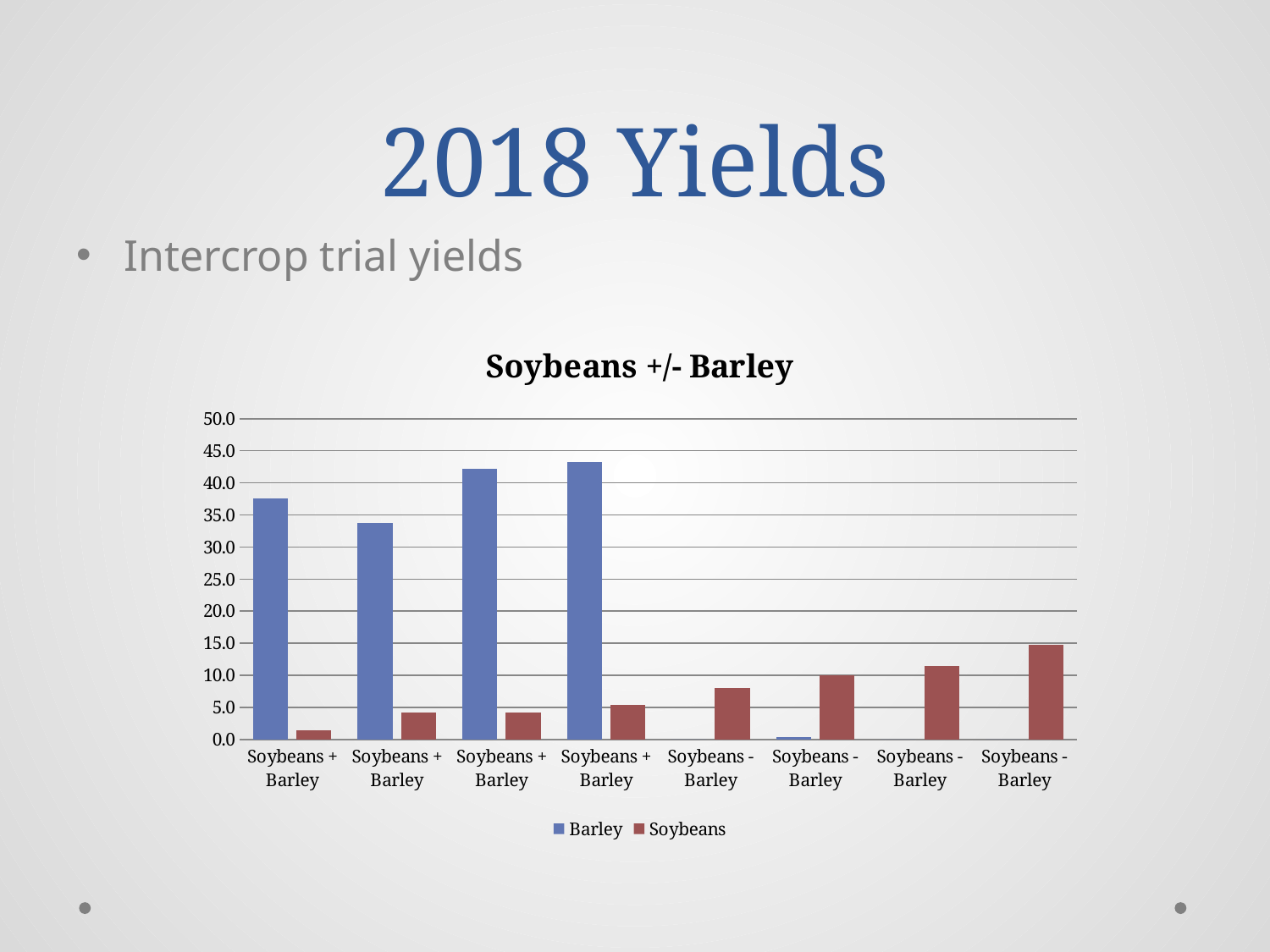
Is the Soybeans value for the last "Soybeans - Barley" category greater or less than 10.0? greater How many series does the legend list? 2 What are the two legend entries of the chart? Barley and Soybeans What kind of chart is shown on the slide? bar chart Is the Barley value for the first "Soybeans + Barley" category greater or less than 30.0? greater What is the title of the chart? Soybeans +/- Barley Which category has the highest Soybeans value? the last "Soybeans - Barley" category (rightmost) Is the Soybeans value for the first "Soybeans - Barley" category (fifth from the left) greater or less than 10.0? less How many categories are shown along the x axis? 8 In the first "Soybeans + Barley" category, which series has the larger value, Barley or Soybeans? Barley Do the Soybeans values rise or fall from left to right across the categories? rise